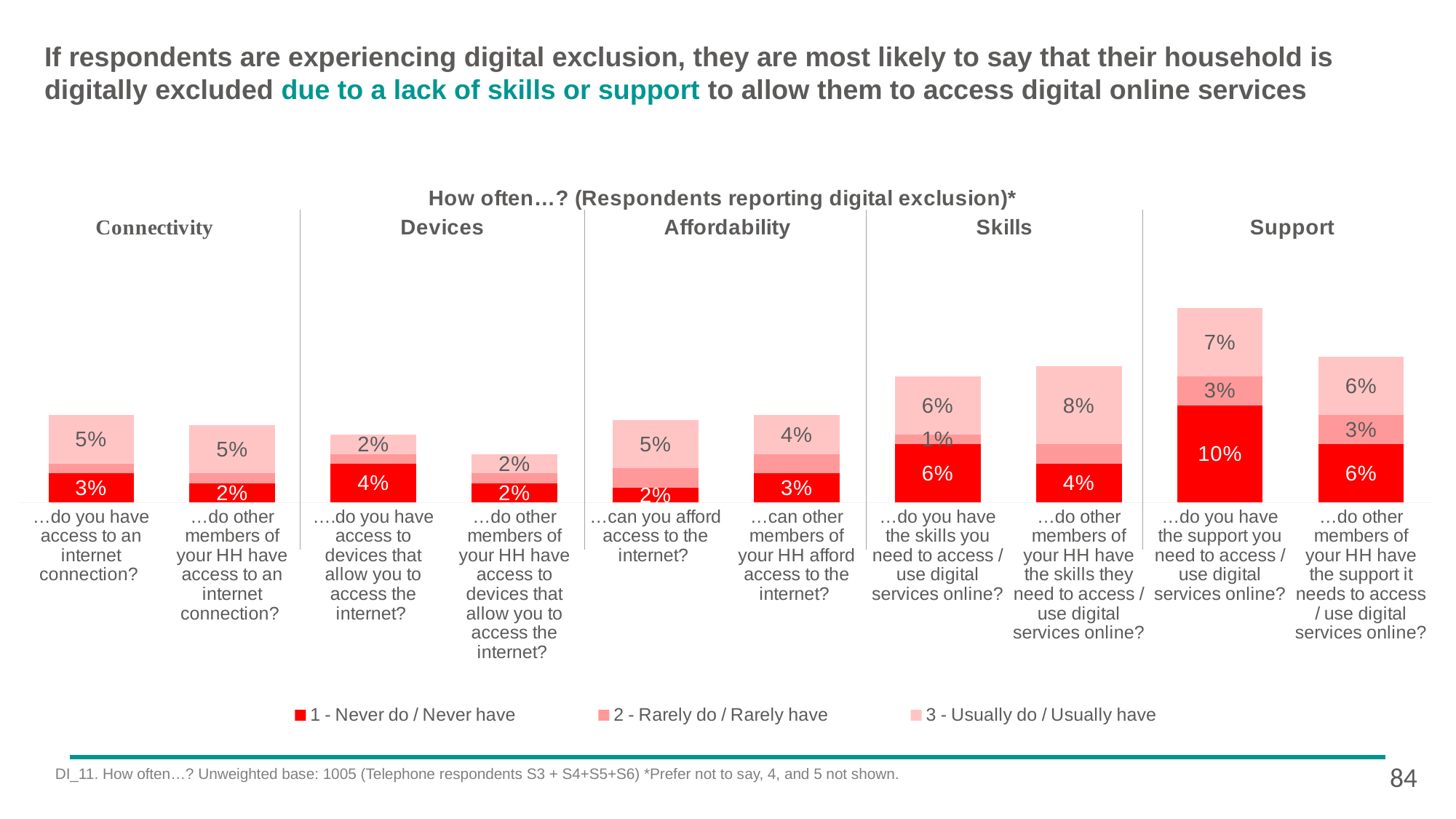
Which category has the highest '1 - Never do / Never have' value? …do you have the support you need to access / use digital services online? What is the difference between the '1 - Never do / Never have' values for '…do you have the support you need to access / use digital services online?' and '…do other members of your HH have the support it needs to access / use digital services online?' 4% What is the '3 - Usually do / Usually have' value for '…do other members of your HH have the skills they need to access / use digital services online?' 8% What is the total of the stacked bar for '…do you have the support you need to access / use digital services online?' 20% What kind of chart is shown on the slide? Stacked bar chart How many bars (question categories) are plotted in the chart? 10 What is the '2 - Rarely do / Rarely have' value for '…do you have the skills you need to access / use digital services online?' 1% How many series does the legend list? 3 What is the '1 - Never do / Never have' value for '…do you have the support you need to access / use digital services online?' 10% Which has the larger '3 - Usually do / Usually have' value: '…do other members of your HH have the skills they need to access / use digital services online?' or '…do you have access to an internet connection?' …do other members of your HH have the skills they need to access / use digital services online? What is the first entry listed in the chart legend? 1 - Never do / Never have What is the total of the stacked bar for '…do you have the skills you need to access / use digital services online?' 13%